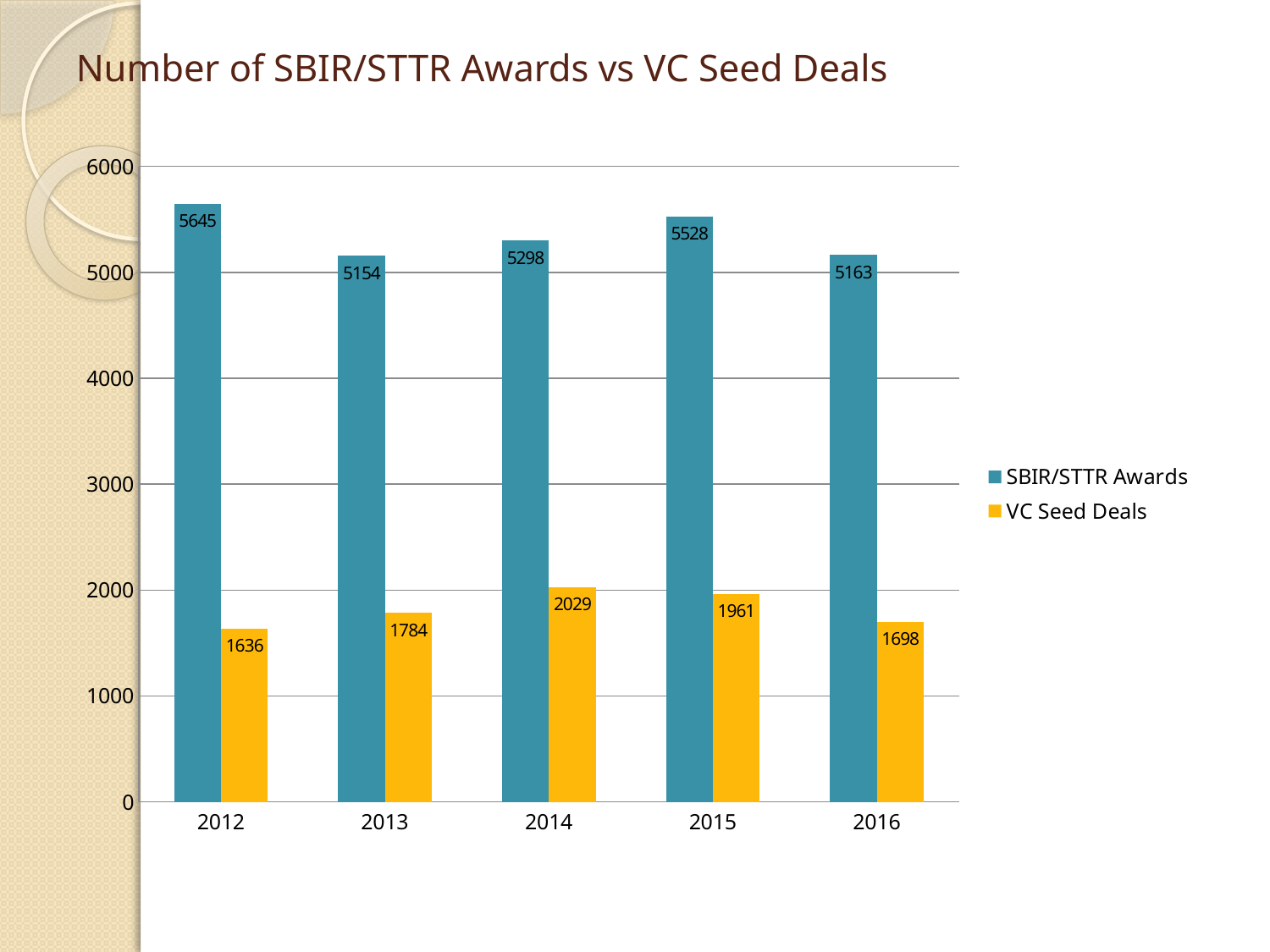
How many years are shown on the x axis? 5 Which year has the highest number of SBIR/STTR Awards? 2012 What kind of chart is shown on the slide? Bar chart What is the number of SBIR/STTR Awards in 2016? 5163 Which is larger: VC Seed Deals in 2013 or VC Seed Deals in 2016? VC Seed Deals in 2013 Which year has the lowest number of SBIR/STTR Awards? 2013 Which year has the lowest number of VC Seed Deals? 2012 What is the title of the chart? Number of SBIR/STTR Awards vs VC Seed Deals What is the difference between SBIR/STTR Awards and VC Seed Deals in 2015? 3567 What is the number of SBIR/STTR Awards in 2012? 5645 What is the number of VC Seed Deals in 2014? 2029 How many series does the legend list? 2